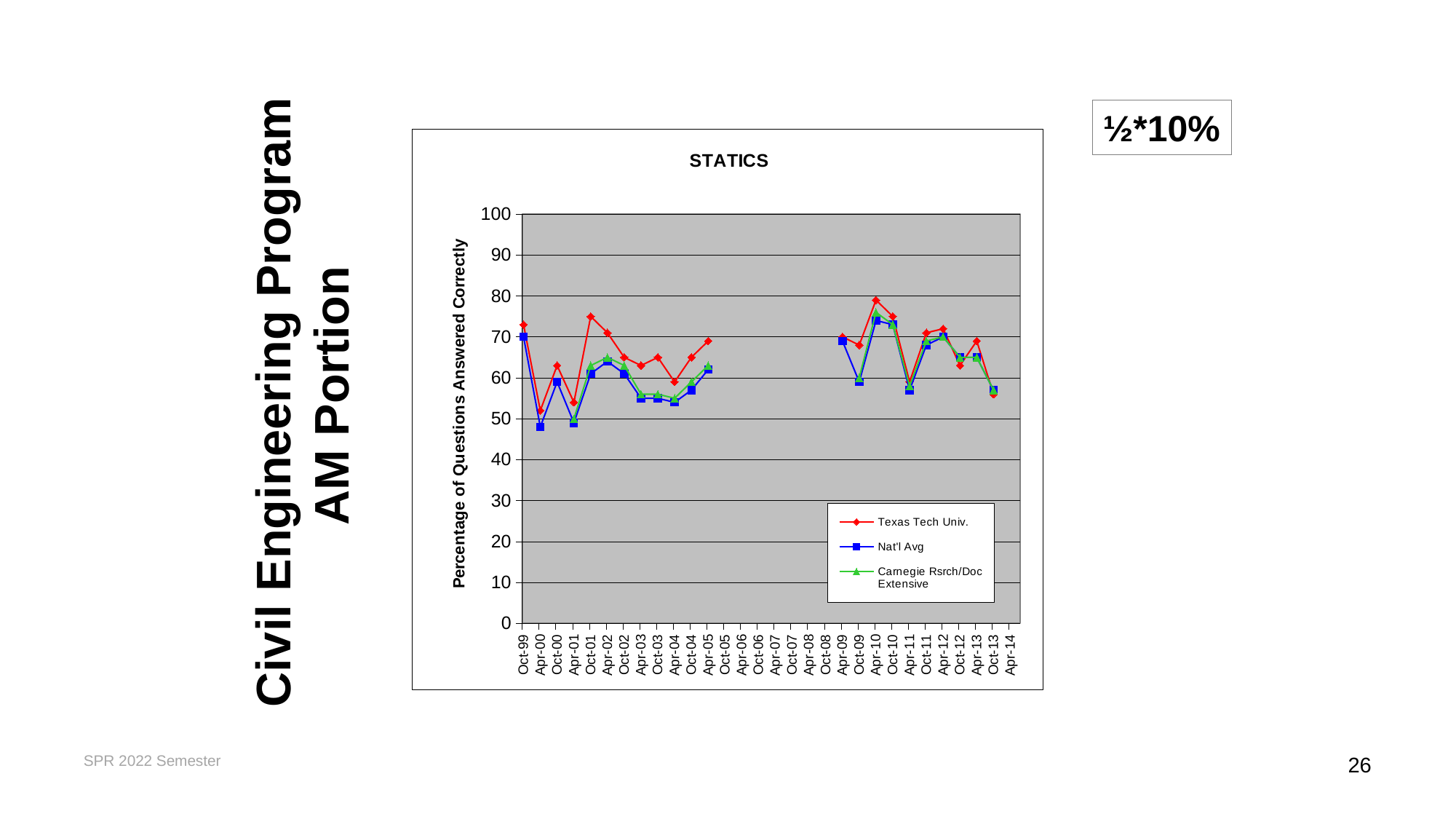
Is the value for Texas Tech Univ. at Apr-10 greater or less than 70? greater Is the value for Nat'l Avg at Apr-00 greater or less than 60? less Is the value for Texas Tech Univ. at Apr-01 greater or less than 60? less Does the Texas Tech Univ. series rise or fall from Oct-99 to Apr-00? fall What is the title of the chart? STATICS At Apr-10, which series has the higher value: Texas Tech Univ. or Nat'l Avg? Texas Tech Univ. How many series does the legend of the STATICS chart list? 3 At Apr-01, which series has the higher value: Texas Tech Univ. or Nat'l Avg? Texas Tech Univ. At which date does the Texas Tech Univ. series reach its highest value? Apr-10 What kind of chart is shown on the slide? line chart What is the label on the vertical axis of the chart? Percentage of Questions Answered Correctly